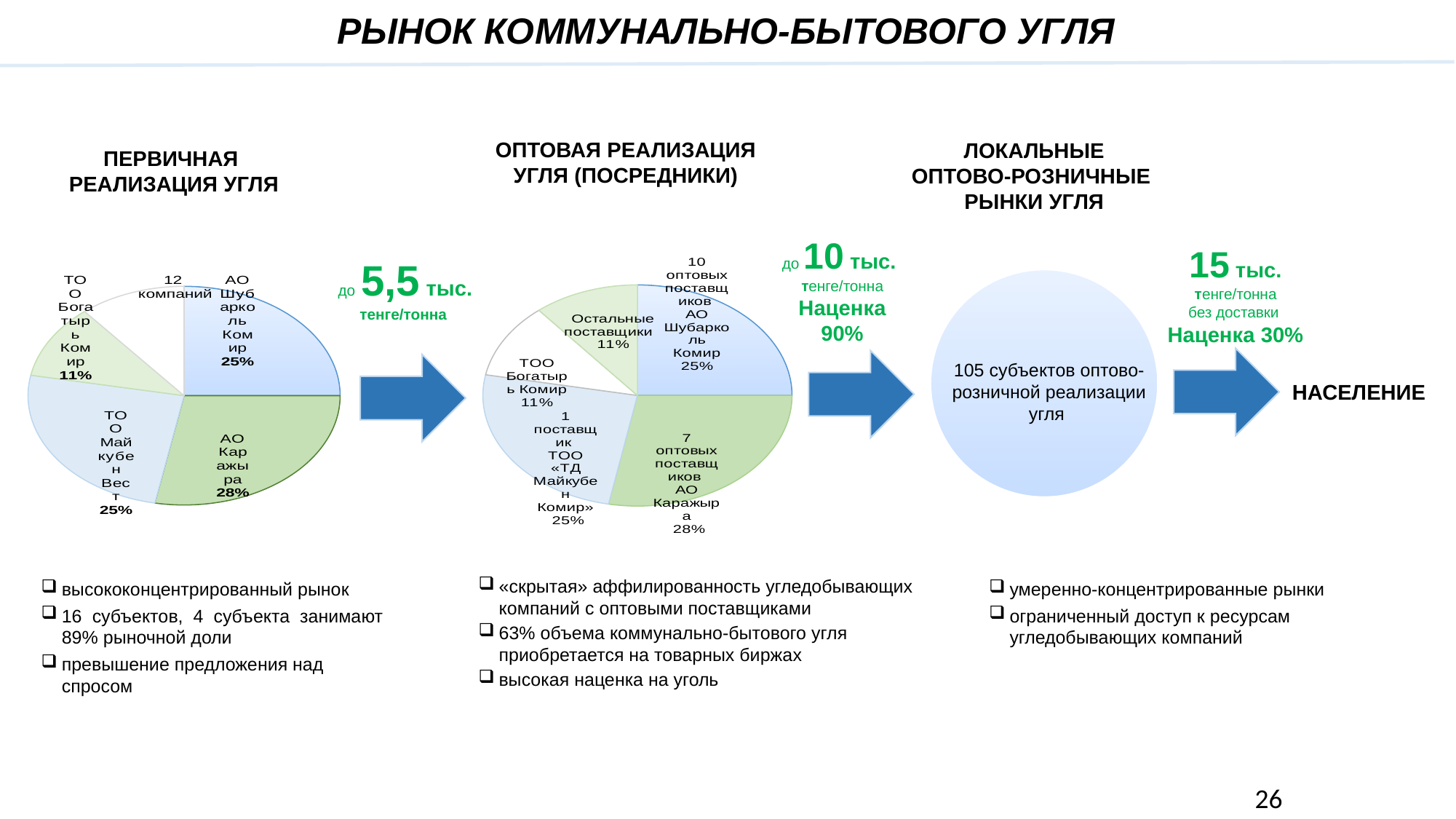
In the middle pie chart (ОПТОВАЯ РЕАЛИЗАЦИЯ УГЛЯ), what share is shown for the 10 оптовых поставщиков АО Шубарколь Комир? 25% In the left pie chart (ПЕРВИЧНАЯ РЕАЛИЗАЦИЯ УГЛЯ), what share is shown for ТОО Майкубен Вест? 25% In the middle pie chart (ОПТОВАЯ РЕАЛИЗАЦИЯ УГЛЯ), what is the combined share of the 7 оптовых поставщиков АО Каражыра and the 10 оптовых поставщиков АО Шубарколь Комир? 53% In the middle pie chart (ОПТОВАЯ РЕАЛИЗАЦИЯ УГЛЯ), what share is shown for the 7 оптовых поставщиков АО Каражыра? 28% In the left pie chart (ПЕРВИЧНАЯ РЕАЛИЗАЦИЯ УГЛЯ), what share is shown for ТОО Богатырь Комир? 11% What type of chart is used under the heading ОПТОВАЯ РЕАЛИЗАЦИЯ УГЛЯ (ПОСРЕДНИКИ)? Pie chart In the middle pie chart (ОПТОВАЯ РЕАЛИЗАЦИЯ УГЛЯ), which is larger: the share of ТОО «ТД Майкубен Комир» or the share of ТОО Богатырь Комир? ТОО «ТД Майкубен Комир» In the left pie chart (ПЕРВИЧНАЯ РЕАЛИЗАЦИЯ УГЛЯ), what share is shown for АО Каражыра? 28% In the left pie chart (ПЕРВИЧНАЯ РЕАЛИЗАЦИЯ УГЛЯ), what is the difference between the shares of АО Каражыра and ТОО Богатырь Комир? 17 percentage points In the left pie chart (ПЕРВИЧНАЯ РЕАЛИЗАЦИЯ УГЛЯ), how many slices does the pie have? 5 In the middle pie chart (ОПТОВАЯ РЕАЛИЗАЦИЯ УГЛЯ), what share is shown for Остальные поставщики? 11% In the left pie chart (ПЕРВИЧНАЯ РЕАЛИЗАЦИЯ УГЛЯ), which labelled company has the largest share? АО Каражыра